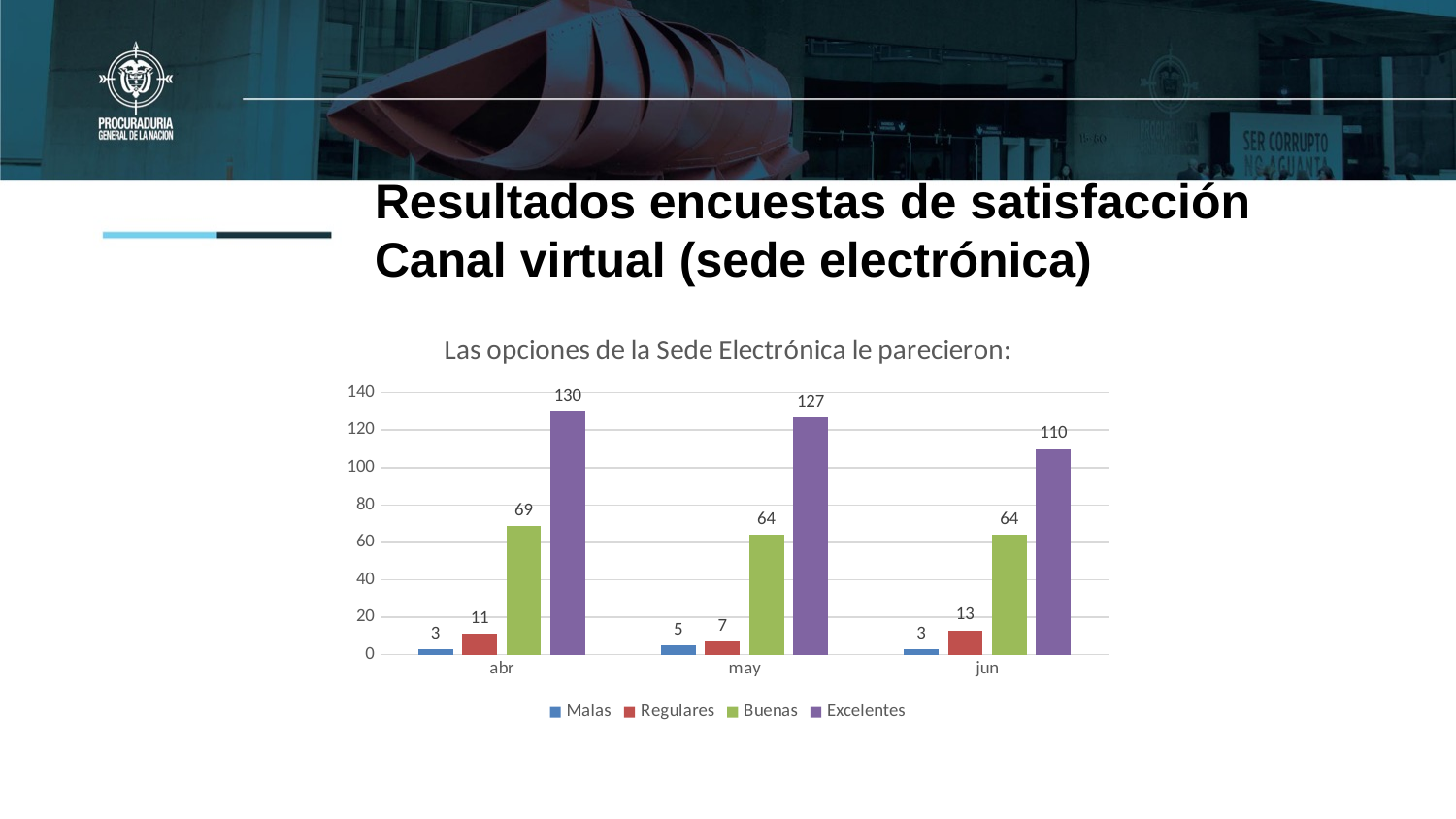
Does the Excelentes value rise or fall from abr to jun? fall How many months are shown on the x axis? 3 In which month is the Excelentes value highest? abr What is the value for Regulares in jun? 13 What is the value for Excelentes in abr? 130 What is the value for Buenas in may? 64 What is the value for Malas in may? 5 What is the difference between the Excelentes values for abr and jun? 20 What kind of chart is shown? bar chart How many series does the legend list? 4 Which is larger, Buenas in abr or Buenas in jun? Buenas in abr In which month is the Regulares value lowest? may